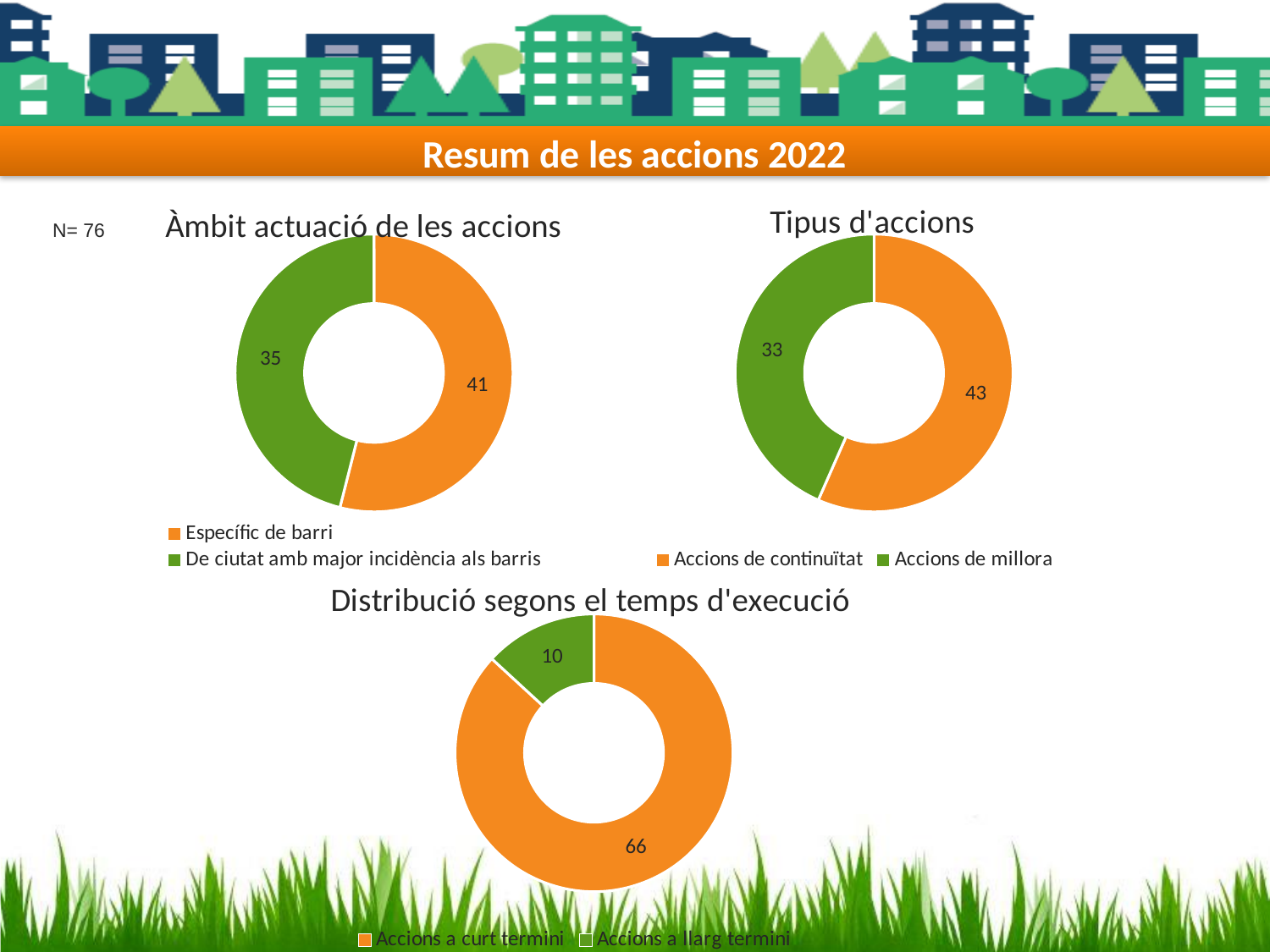
In the 'Àmbit actuació de les accions' chart, what is the difference between 'Específic de barri' and 'De ciutat amb major incidència als barris'? 6 In the 'Tipus d'accions' chart, which category has the smallest value? Accions de millora In the 'Àmbit actuació de les accions' chart, what is the value for 'De ciutat amb major incidència als barris'? 35 In the 'Tipus d'accions' chart, what is the value for 'Accions de millora'? 33 In the 'Àmbit actuació de les accions' chart, what is the value for 'Específic de barri'? 41 In the 'Distribució segons el temps d'execució' chart, what is the value for 'Accions a llarg termini'? 10 In the 'Distribució segons el temps d'execució' chart, which category has the largest value? Accions a curt termini In the 'Tipus d'accions' chart, what is the value for 'Accions de continuïtat'? 43 In the 'Tipus d'accions' chart, which is larger: 'Accions de continuïtat' or 'Accions de millora'? Accions de continuïtat In the 'Distribució segons el temps d'execució' chart, what is the difference between 'Accions a curt termini' and 'Accions a llarg termini'? 56 What kind of chart is the 'Tipus d'accions' chart? Doughnut chart In the 'Distribució segons el temps d'execució' chart, what is the value for 'Accions a curt termini'? 66